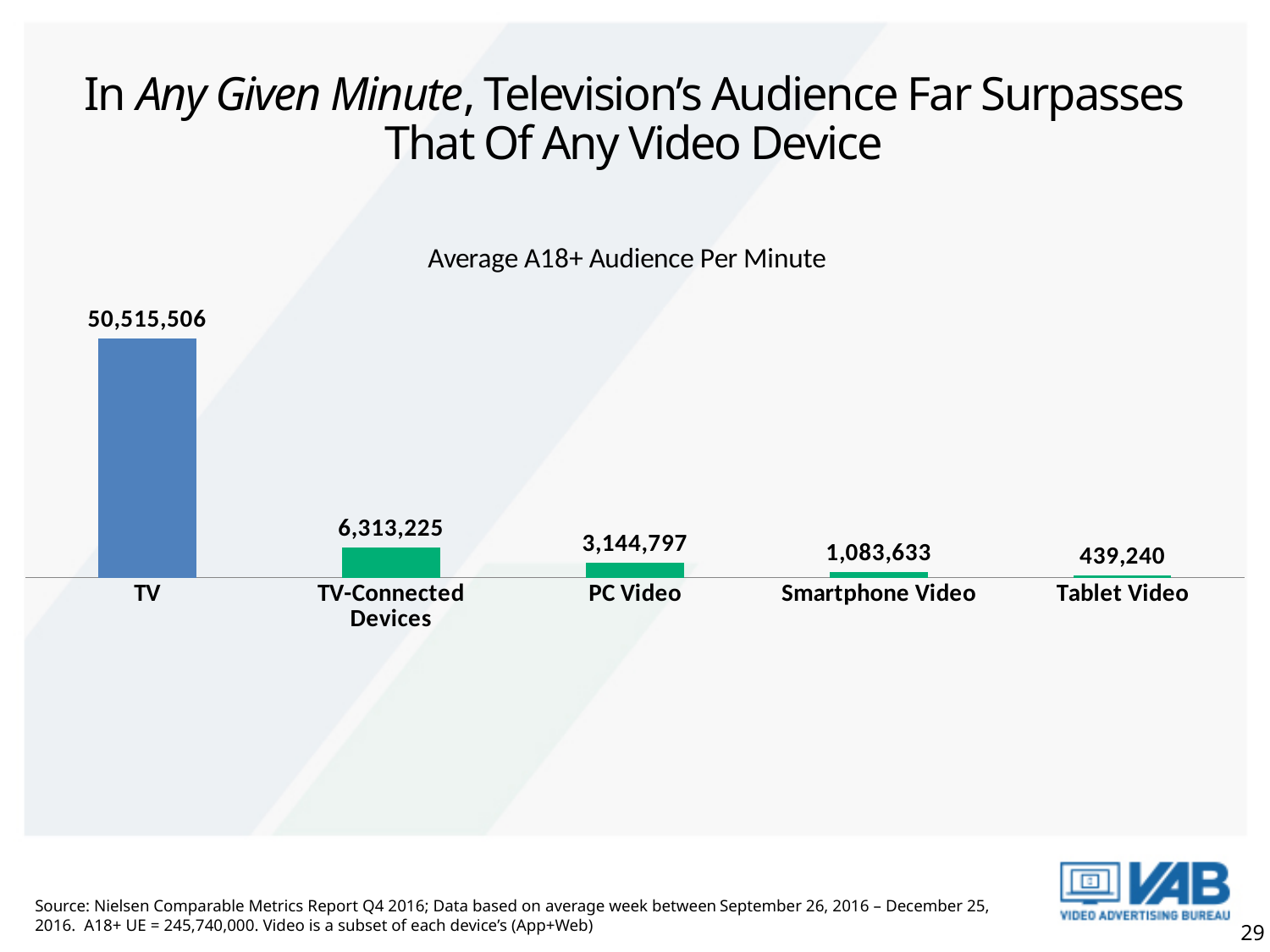
What is the average A18+ audience per minute for Smartphone Video? 1,083,633 What is the difference between the PC Video audience and the Smartphone Video audience? 2,061,164 What is the average A18+ audience per minute for PC Video? 3,144,797 What type of chart is shown on the slide? Bar chart Which is larger, the audience for Smartphone Video or for Tablet Video? Smartphone Video What is the average A18+ audience per minute for TV-Connected Devices? 6,313,225 What is the average A18+ audience per minute for TV? 50,515,506 What is the average A18+ audience per minute for Tablet Video? 439,240 What is the difference between the TV audience and the TV-Connected Devices audience? 44,202,281 Which category has the highest average A18+ audience per minute? TV Which category has the lowest average A18+ audience per minute? Tablet Video How many categories are shown in the chart? 5